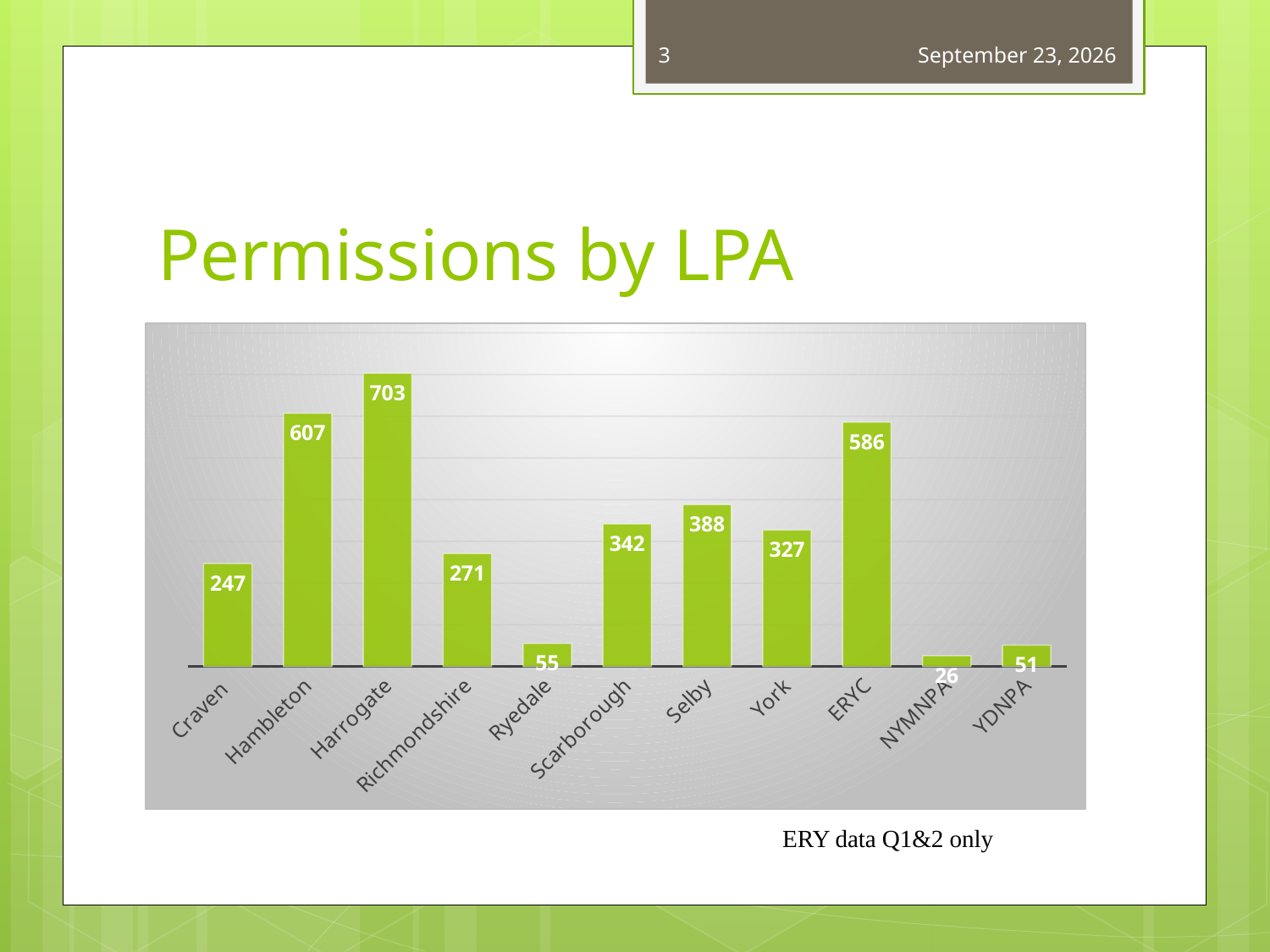
What kind of chart is shown on the slide? Bar chart What is the difference between the values for YDNPA and Ryedale? 4 Which is larger, the value for Selby or the value for York? Selby What is the value for ERYC? 586 How many LPAs are shown on the chart? 11 What is the value for Harrogate? 703 What is the difference between the values for Hambleton and Craven? 360 What is the value for Richmondshire? 271 Which LPA has the highest number of permissions? Harrogate What is the value for NYMNPA? 26 What is the title of the slide containing the chart? Permissions by LPA Which LPA has the lowest number of permissions? NYMNPA